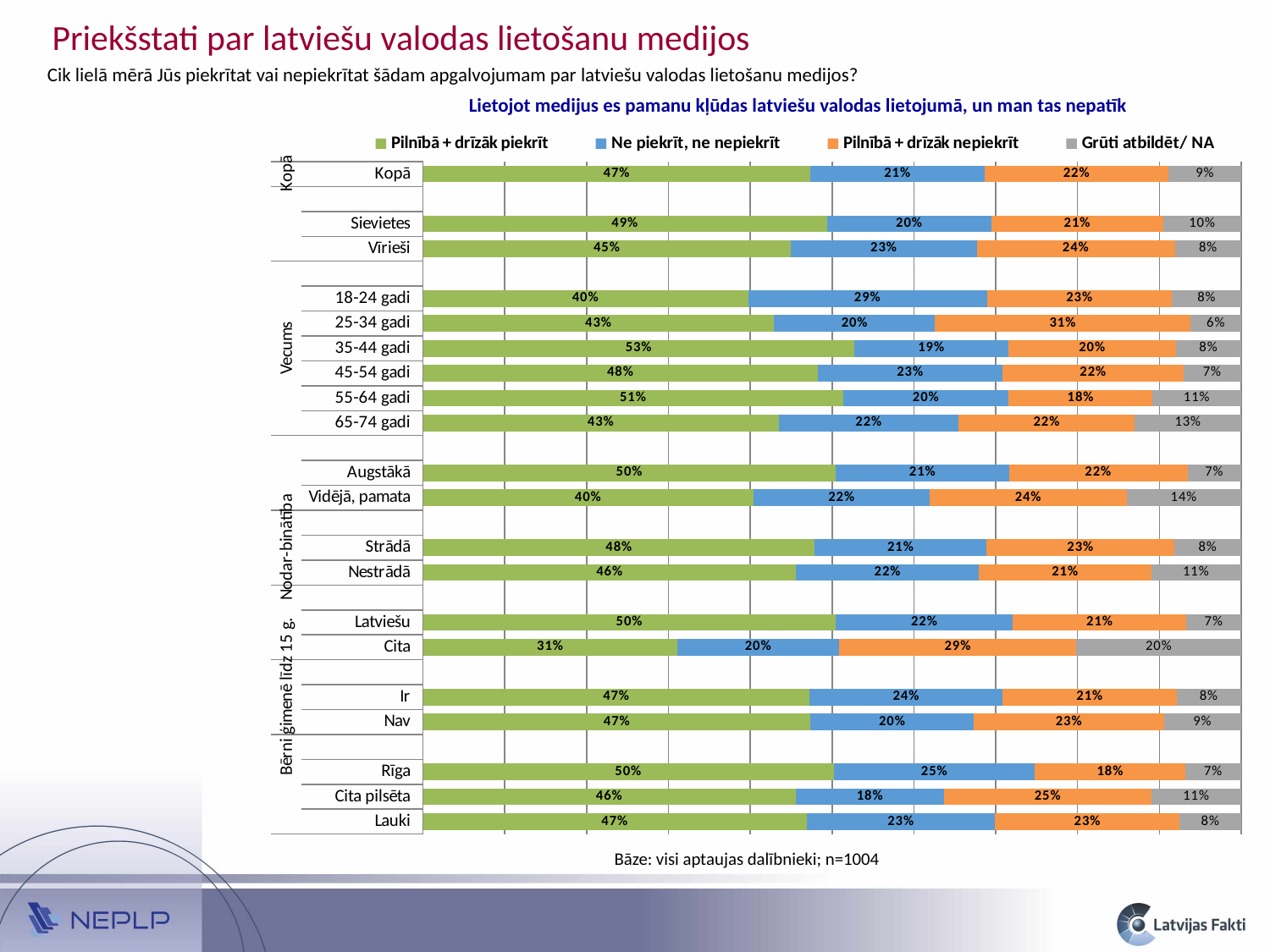
Which category has the highest value for "Pilnībā + drīzāk piekrīt"? 35-44 gadi What is the value of "Pilnībā + drīzāk piekrīt" for Kopā? 47% How many series does the legend list? 4 Which category has the lowest value for "Pilnībā + drīzāk piekrīt"? Cita What is the value of "Pilnībā + drīzāk nepiekrīt" for 25-34 gadi? 31% How many categories (bars) are plotted in the chart? 20 What is the title of the chart? Lietojot medijus es pamanu kļūdas latviešu valodas lietojumā, un man tas nepatīk What is the difference between the "Pilnībā + drīzāk piekrīt" values for Sievietes and Vīrieši? 4% What is the value of "Grūti atbildēt/ NA" for Cita? 20% What is the value of "Ne piekrīt, ne nepiekrīt" for 18-24 gadi? 29% Which is larger: the "Ne piekrīt, ne nepiekrīt" value for Rīga or for Cita pilsēta? Rīga What kind of chart is shown on the slide? Stacked bar chart